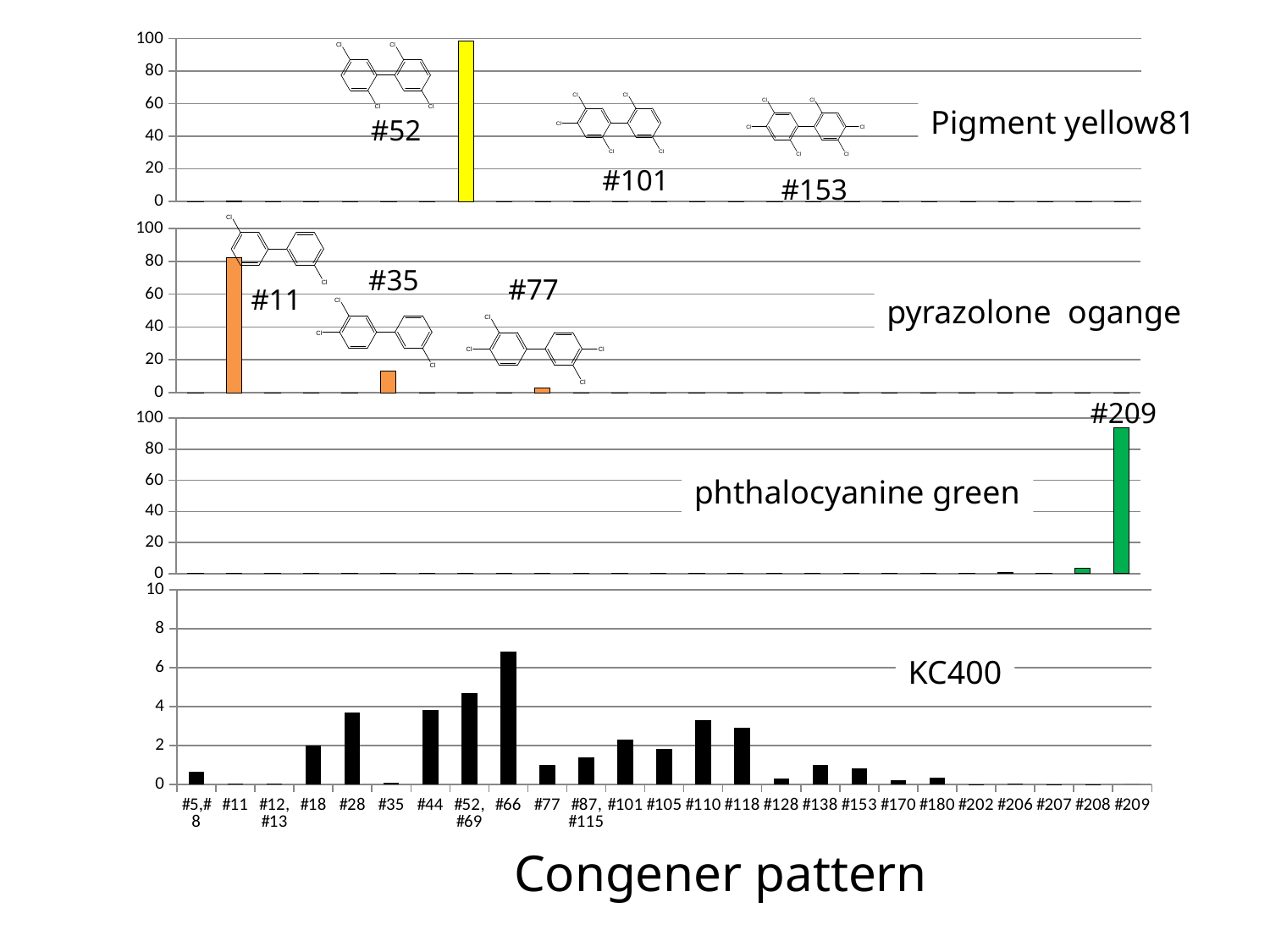
In the Pigment yellow81 chart, is the value for #52 greater or less than 80? greater What kind of chart is the KC400 chart? bar chart In the KC400 chart, is the value for #66 greater or less than 6? greater In the KC400 chart, which congener has the highest bar? #66 What colour are the bars in the phthalocyanine green chart? green In the phthalocyanine green chart, is the value for #209 greater or less than 80? greater In the KC400 chart, which is larger, the value for #28 or the value for #77? #28 In the pyrazolone orange chart, which congener has the highest bar? #11 In the Pigment yellow81 chart, which congener has the highest bar? #52 How many congener categories are listed along the x axis of the KC400 chart? 25